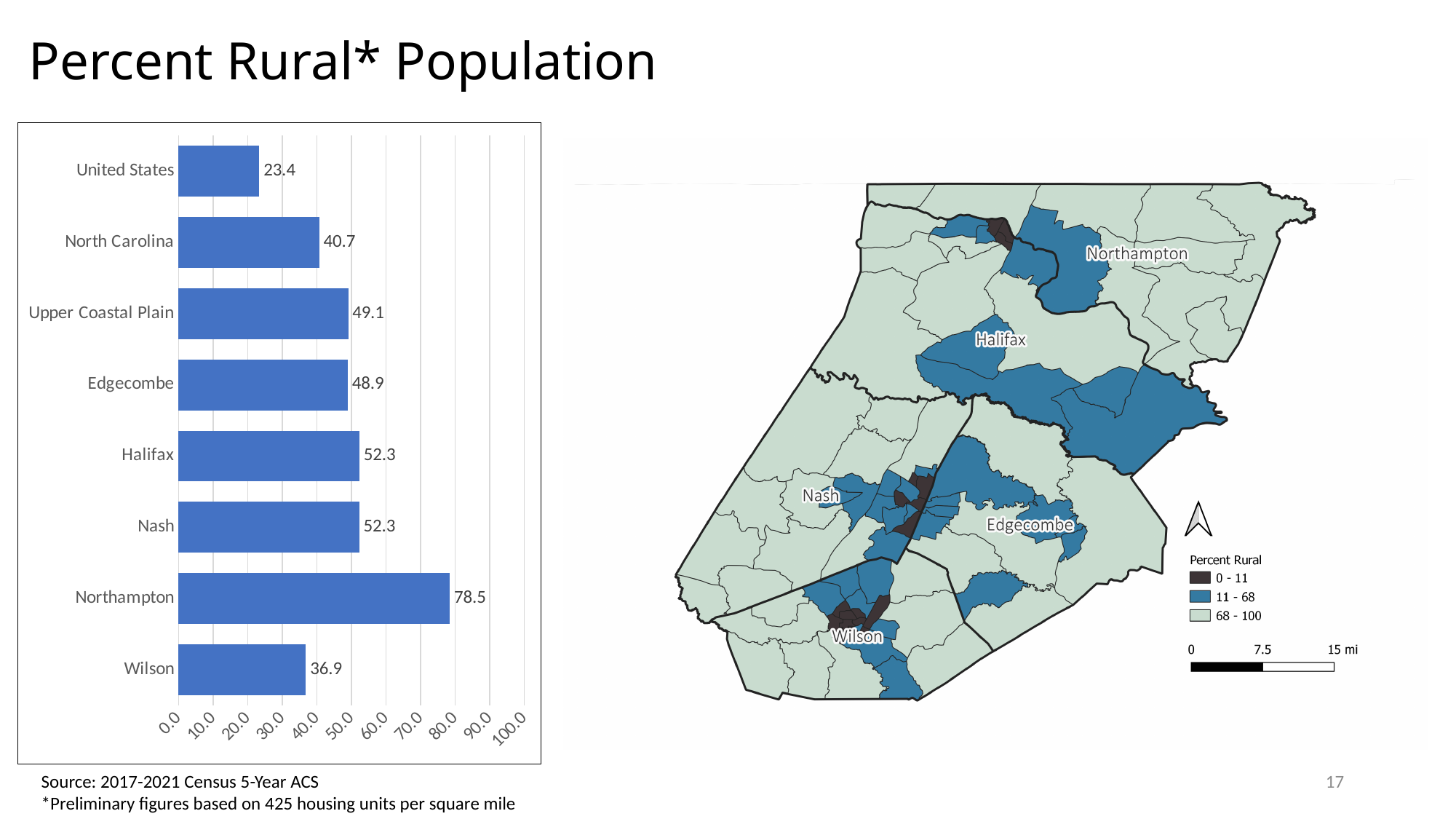
What is the value for Northampton in the bar chart? 78.5 What is the title of the slide? Percent Rural* Population What is the value for Upper Coastal Plain in the bar chart? 49.1 What kind of chart is shown on the left of the slide? bar chart How many categories are shown in the bar chart? 8 Which category has the highest value in the bar chart? Northampton Which is larger in the bar chart, the value for Edgecombe or the value for Wilson? Edgecombe What is the value for the United States in the bar chart? 23.4 What is the difference between the values for Northampton and Wilson in the bar chart? 41.6 Which category has the lowest value in the bar chart? United States What is the difference between the values for North Carolina and the United States in the bar chart? 17.3 What is the value for Wilson in the bar chart? 36.9